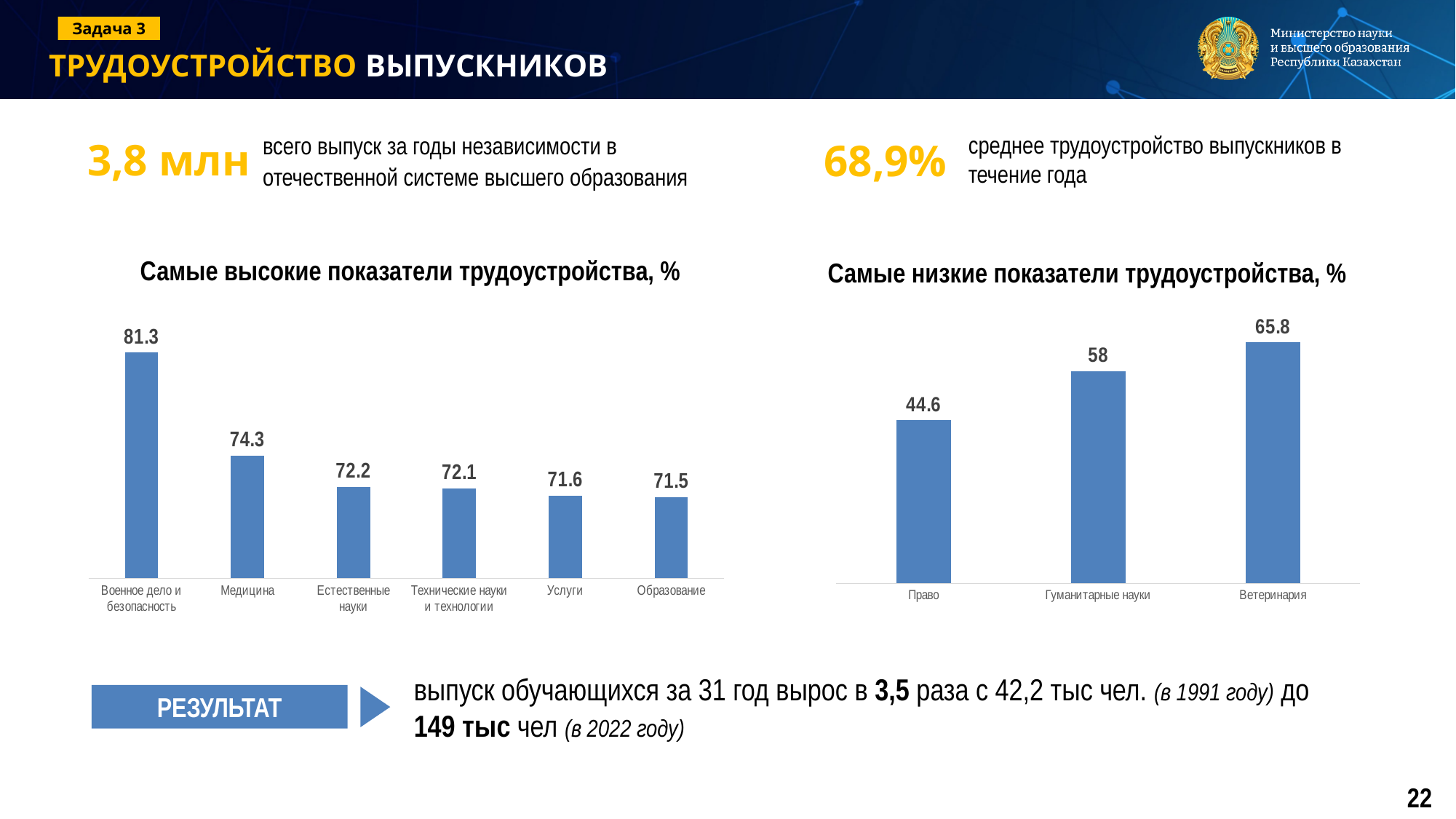
In the chart 'Самые низкие показатели трудоустройства, %', how many categories are shown? 3 In the chart 'Самые высокие показатели трудоустройства, %', what is the value for Услуги? 71.6 In the chart 'Самые высокие показатели трудоустройства, %', which category has the lowest value? Образование What type of chart is 'Самые низкие показатели трудоустройства, %'? Bar chart In the chart 'Самые низкие показатели трудоустройства, %', what is the value for Право? 44.6 In the chart 'Самые низкие показатели трудоустройства, %', what is the difference between Ветеринария and Гуманитарные науки? 7.8 In the chart 'Самые низкие показатели трудоустройства, %', which category has the highest value? Ветеринария In the chart 'Самые высокие показатели трудоустройства, %', what is the difference between Военное дело и безопасность and Медицина? 7 In the chart 'Самые высокие показатели трудоустройства, %', how many categories are shown? 6 In the chart 'Самые высокие показатели трудоустройства, %', which category has the highest value? Военное дело и безопасность In the chart 'Самые низкие показатели трудоустройства, %', which category has the lowest value? Право In the chart 'Самые высокие показатели трудоустройства, %', what is the value for Медицина? 74.3